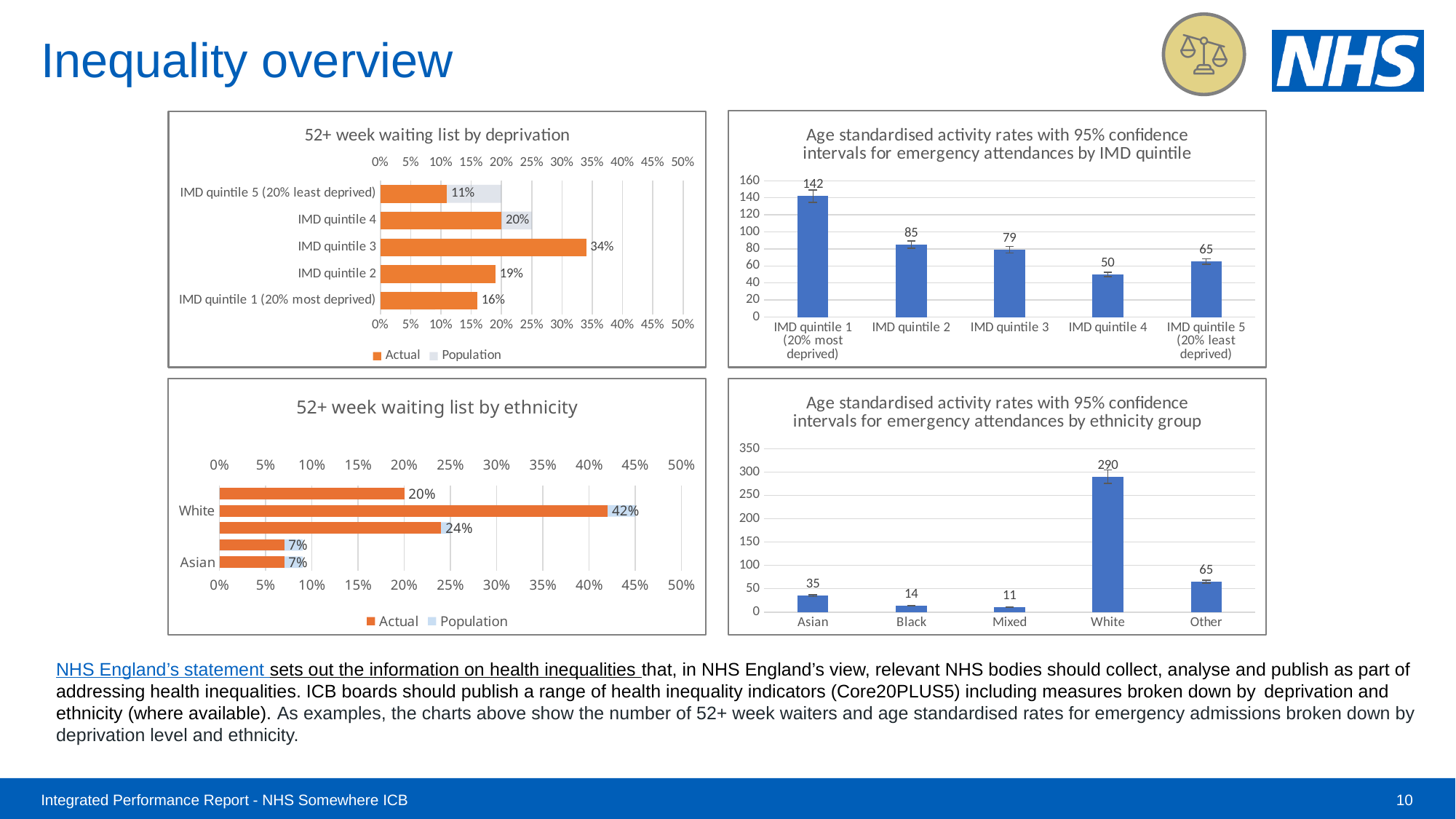
In the chart titled 'Age standardised activity rates with 95% confidence intervals for emergency attendances by IMD quintile', which IMD quintile has the lowest value? IMD quintile 4 In the chart titled 'Age standardised activity rates with 95% confidence intervals for emergency attendances by ethnicity group', which is larger, the value for Asian or the value for Other? Other In the chart titled 'Age standardised activity rates with 95% confidence intervals for emergency attendances by ethnicity group', how many ethnicity groups are shown on the x axis? 5 In the chart titled 'Age standardised activity rates with 95% confidence intervals for emergency attendances by IMD quintile', what is the value for IMD quintile 1 (20% most deprived)? 142 In the chart titled '52+ week waiting list by deprivation', what is the difference between the Actual values for IMD quintile 4 and IMD quintile 5 (20% least deprived)? 9% In the chart titled '52+ week waiting list by deprivation', what is the Actual value for IMD quintile 3? 34% In the chart titled 'Age standardised activity rates with 95% confidence intervals for emergency attendances by ethnicity group', what is the value for White? 290 In the chart titled 'Age standardised activity rates with 95% confidence intervals for emergency attendances by IMD quintile', what is the difference between the values for IMD quintile 2 and IMD quintile 3? 6 In the chart titled '52+ week waiting list by deprivation', which IMD quintile has the highest Actual value? IMD quintile 3 In the chart titled '52+ week waiting list by deprivation', how many series does the legend list? 2 In the chart titled 'Age standardised activity rates with 95% confidence intervals for emergency attendances by ethnicity group', which ethnicity group has the lowest value? Mixed What kind of chart is the chart titled '52+ week waiting list by ethnicity'? Bar chart